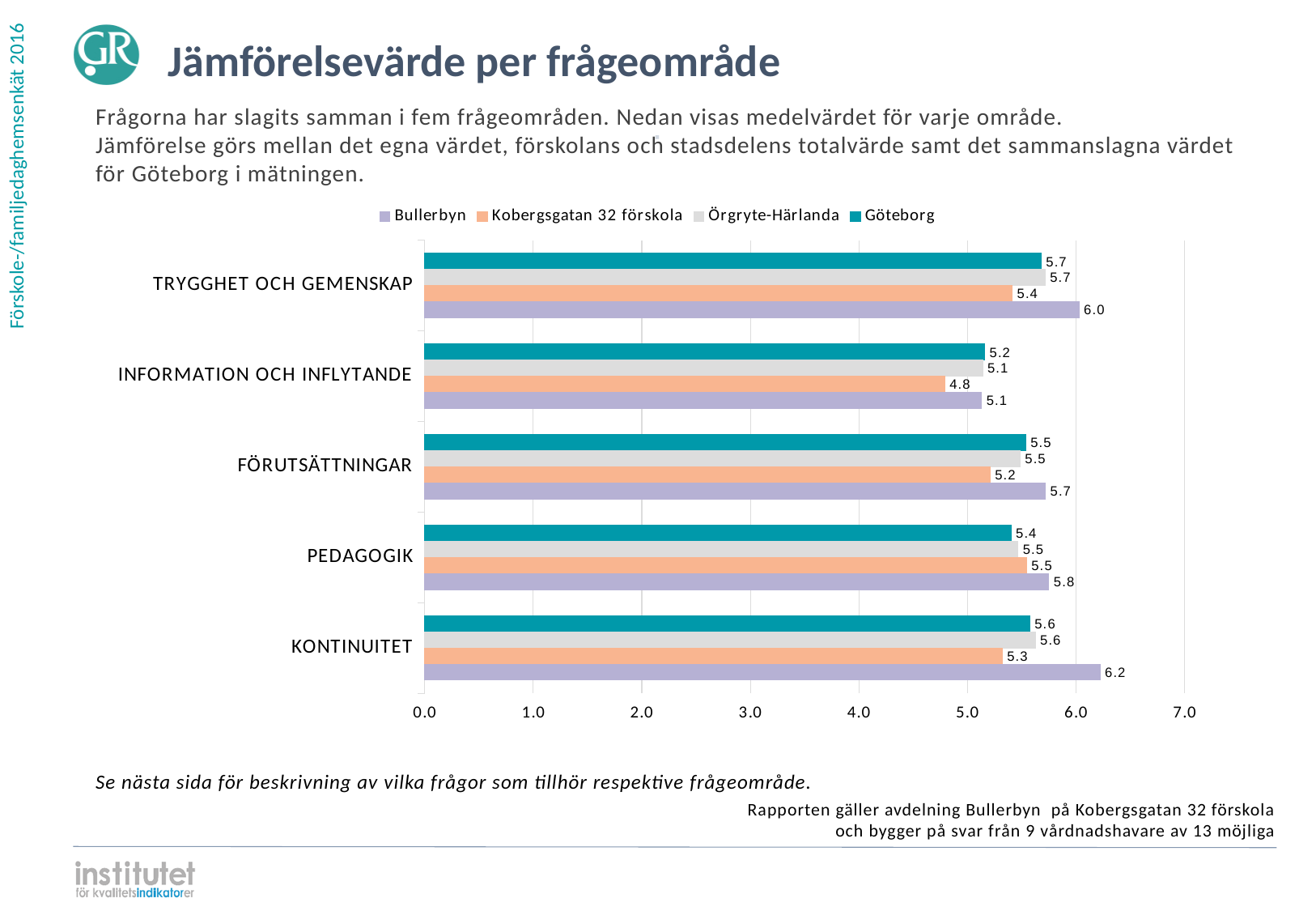
In which category does Bullerbyn have its highest value? KONTINUITET What is the difference between Bullerbyn and Kobergsgatan 32 förskola in TRYGGHET OCH GEMENSKAP? 0.6 What is the value for Göteborg in PEDAGOGIK? 5.4 What is the value for Örgryte-Härlanda in FÖRUTSÄTTNINGAR? 5.5 What is the value for Kobergsgatan 32 förskola in INFORMATION OCH INFLYTANDE? 4.8 How many question areas (categories) are shown on the chart? 5 What kind of chart is shown on the slide? bar chart In which category does Kobergsgatan 32 förskola have its lowest value? INFORMATION OCH INFLYTANDE Which is larger in PEDAGOGIK: Bullerbyn or Göteborg? Bullerbyn Which series is shown in teal in the legend? Göteborg What is the value for Bullerbyn in KONTINUITET? 6.2 How many series does the legend list? 4